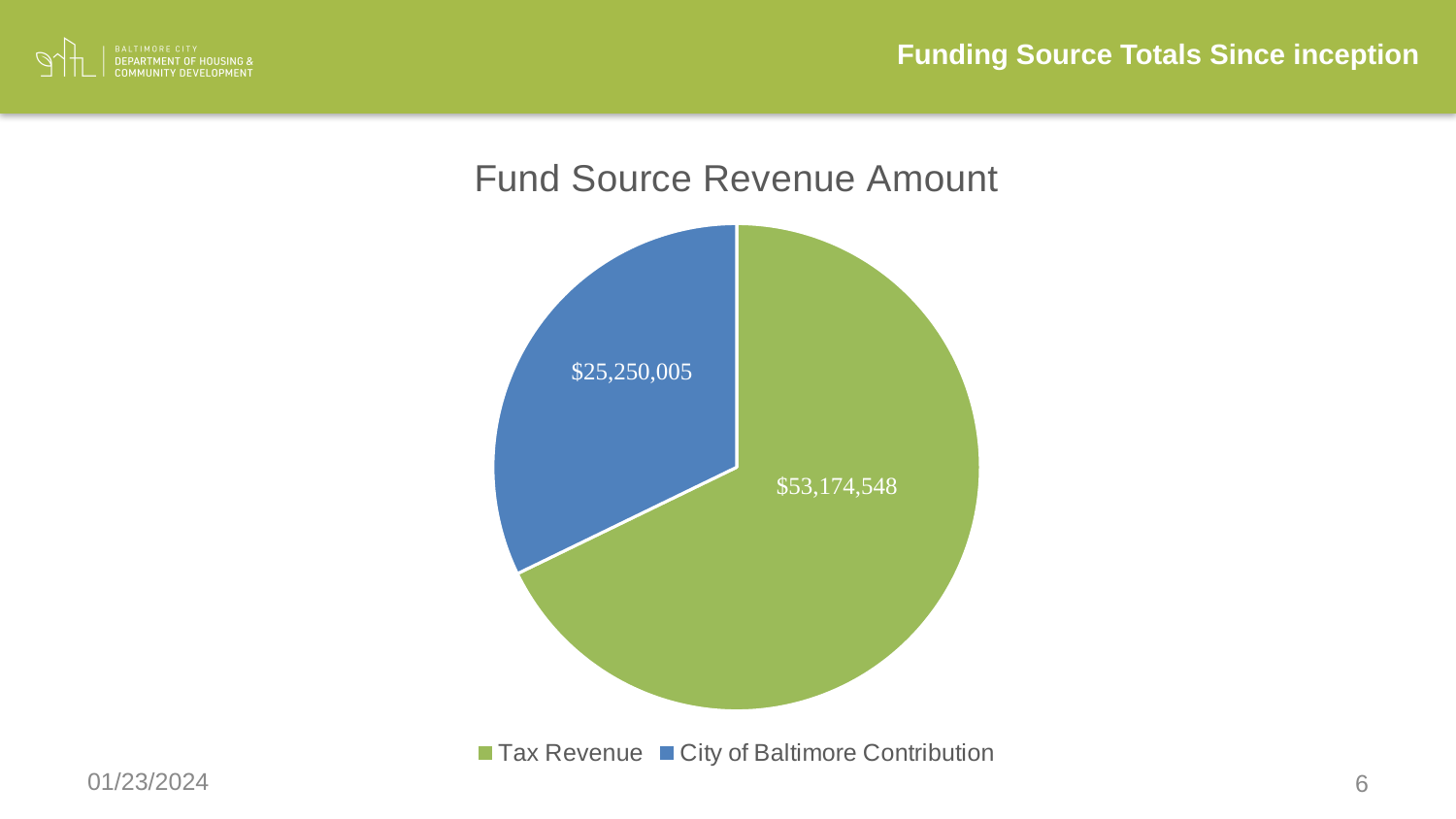
What is the title of the chart? Fund Source Revenue Amount How many slices does the pie chart have? 2 What is the value for Tax Revenue in the pie chart? $53,174,548 What is the value for City of Baltimore Contribution in the pie chart? $25,250,005 What type of chart is shown on the slide? Pie chart Which colour represents City of Baltimore Contribution in the pie chart? Blue Which funding source has the largest slice of the pie? Tax Revenue What share of the total does Tax Revenue represent, to one decimal place? 67.8% Which funding source has the smallest slice of the pie? City of Baltimore Contribution What is the total of the two funding sources shown in the pie chart? $78,424,553 What is the difference between the Tax Revenue and City of Baltimore Contribution amounts? $27,924,543 Which is larger, Tax Revenue or City of Baltimore Contribution? Tax Revenue